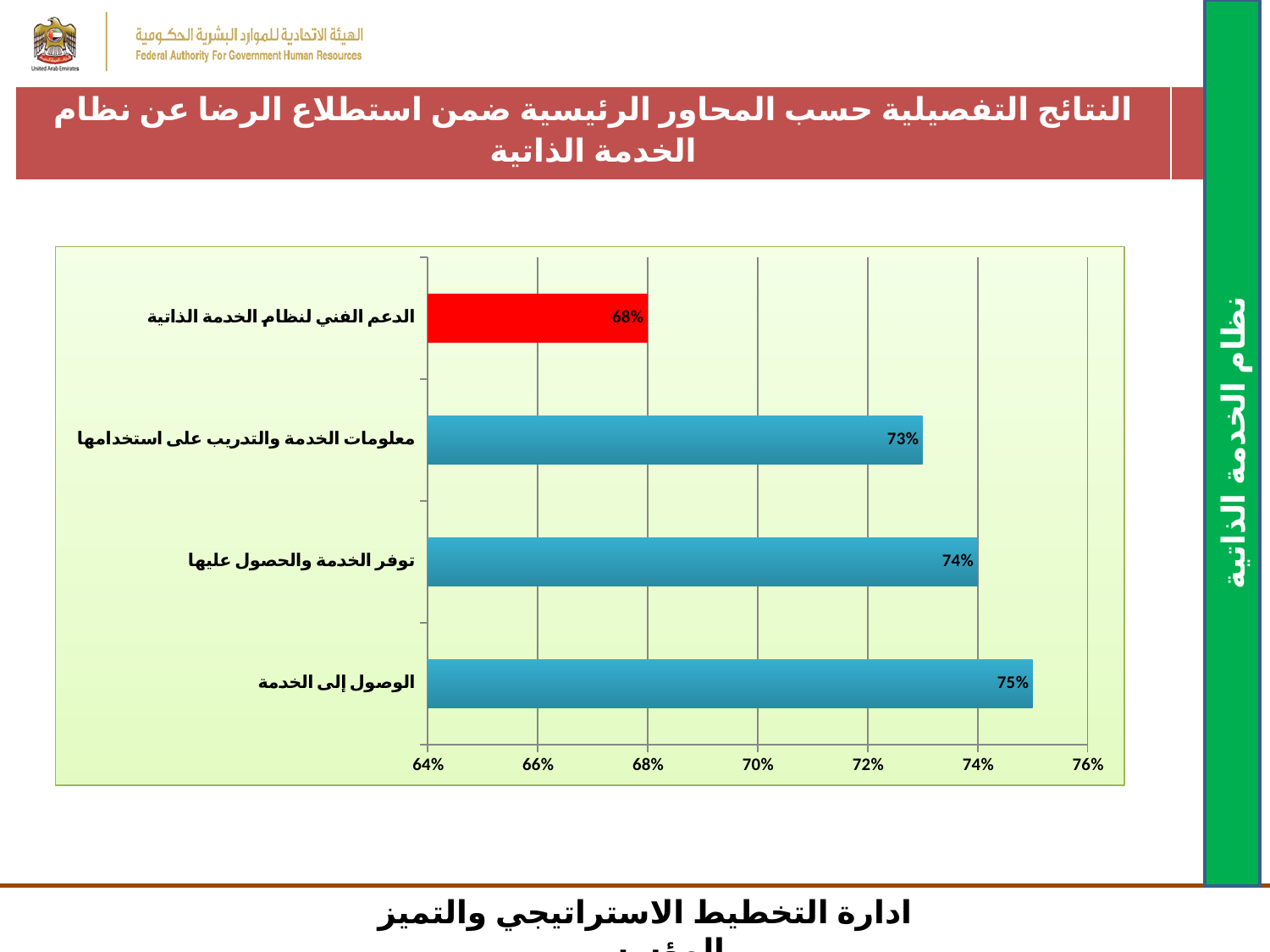
What is the value for توفر الخدمة والحصول عليها? 74% What is the difference between the values for الوصول إلى الخدمة and الدعم الفني لنظام الخدمة الذاتية? 7% What kind of chart is shown on the slide? bar chart Which bar is coloured red rather than blue? الدعم الفني لنظام الخدمة الذاتية Which category has the lowest value? الدعم الفني لنظام الخدمة الذاتية What is the value for معلومات الخدمة والتدريب على استخدامها? 73% Is the value for معلومات الخدمة والتدريب على استخدامها greater or less than 70%? greater What is the value for الدعم الفني لنظام الخدمة الذاتية? 68% How many categories are shown in the chart? 4 What is the value for الوصول إلى الخدمة? 75% Which is larger, the value for توفر الخدمة والحصول عليها or the value for معلومات الخدمة والتدريب على استخدامها? توفر الخدمة والحصول عليها Which category has the highest value? الوصول إلى الخدمة